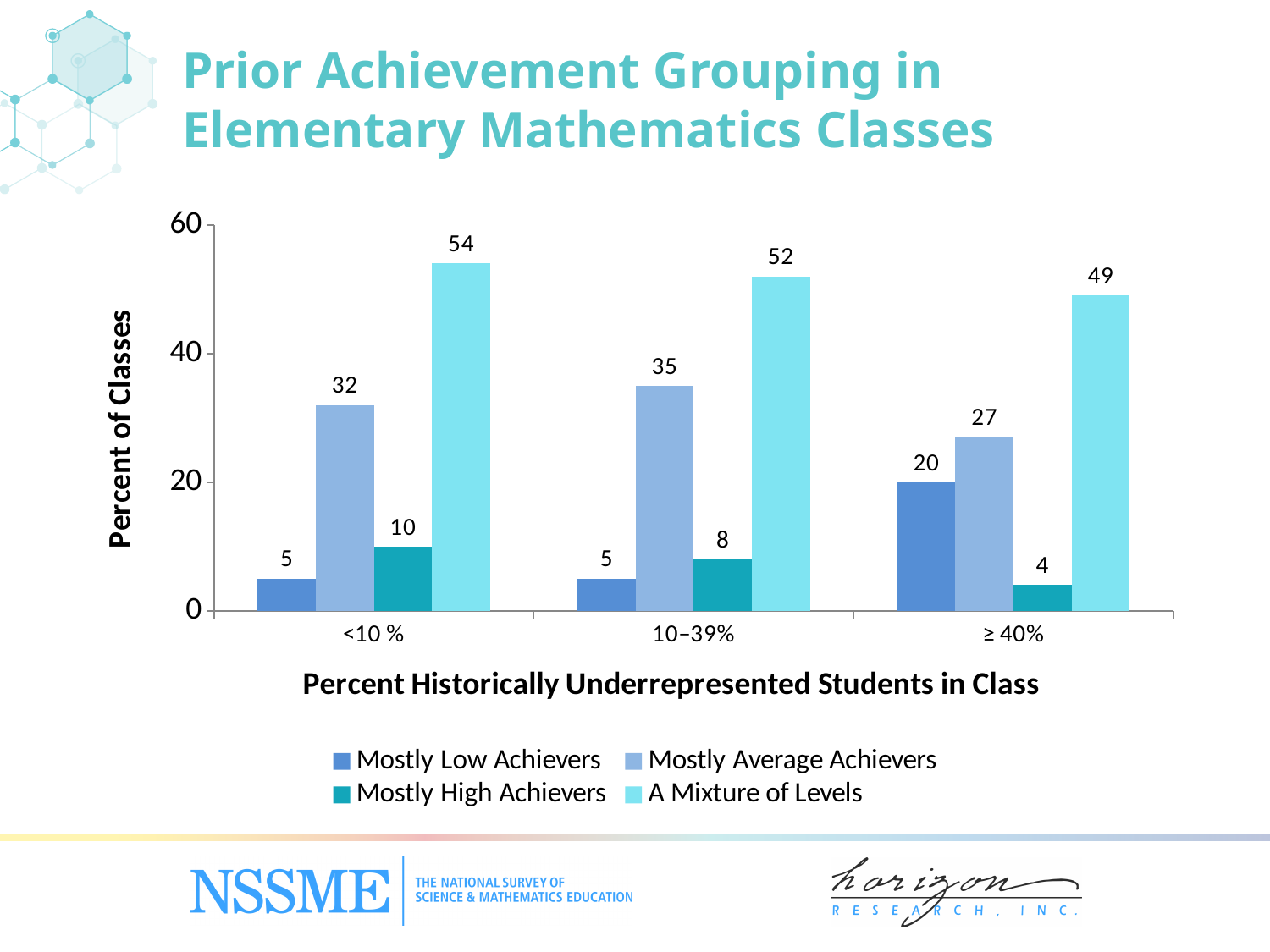
Do the values for A Mixture of Levels rise or fall across the categories from <10 % to ≥ 40%? Fall What kind of chart is shown on the slide? Bar chart How many categories are shown on the x axis? 3 What is the value for Mostly Low Achievers in the ≥ 40% category? 20 What is the value for Mostly High Achievers in the 10–39% category? 8 How many series does the legend list? 4 Which category has the highest value for Mostly Average Achievers? 10–39% What is the value for A Mixture of Levels in the <10 % category? 54 What is the difference between A Mixture of Levels and Mostly Average Achievers in the ≥ 40% category? 22 Which category has the lowest value for Mostly High Achievers? ≥ 40% What is the label of the y axis? Percent of Classes Which is larger: Mostly Average Achievers in <10 % or Mostly Average Achievers in ≥ 40%? <10 %